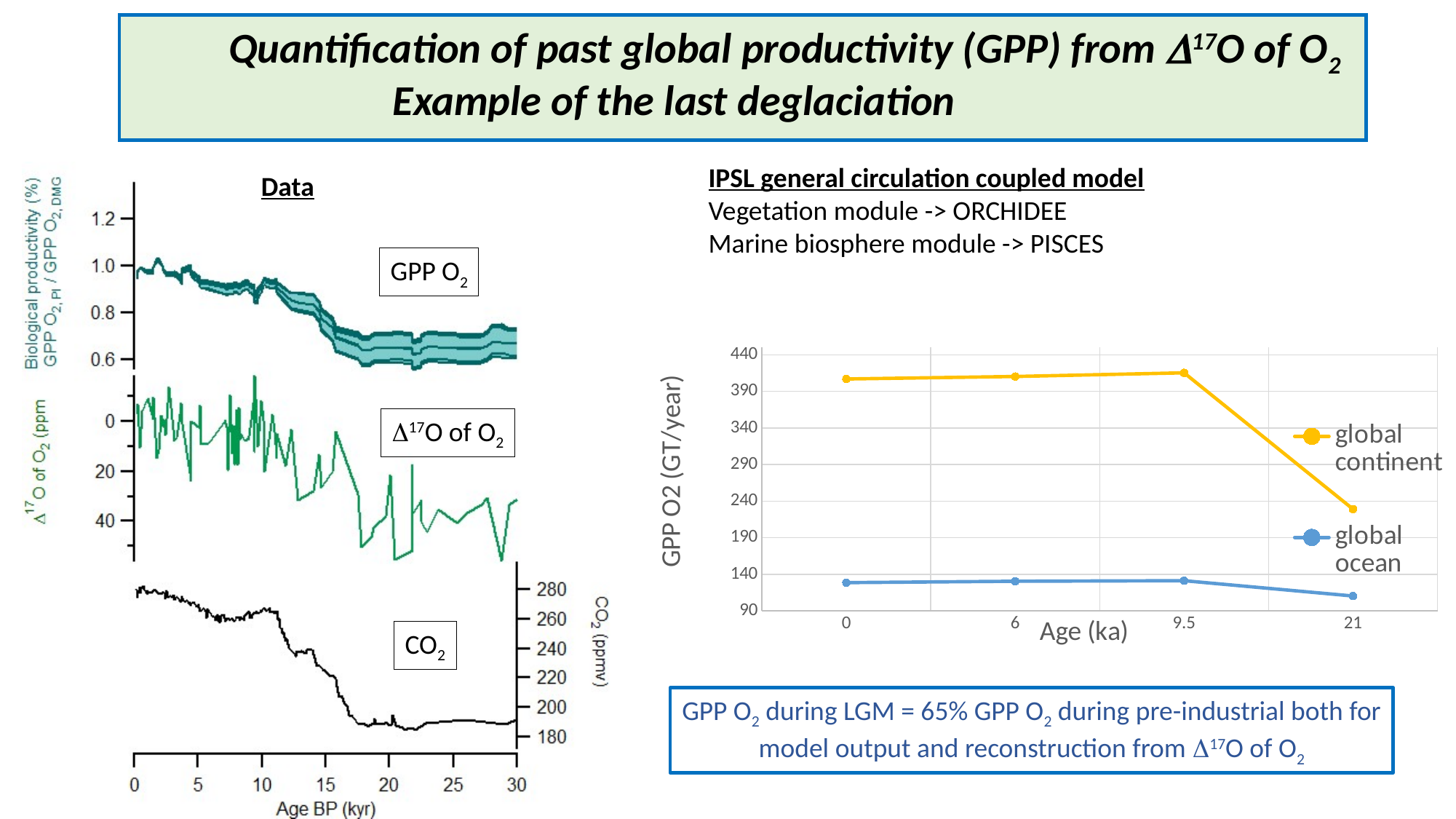
On the right-hand chart of GPP O2 versus Age (ka), what is the label of the y axis? GPP O2 (GT/year) On the left-hand Data panel, does the CO2 curve rise or fall as Age BP increases from 0 to 30 kyr? fall On the right-hand chart of GPP O2 versus Age (ka), is the global ocean value at 21 ka greater or less than 140? less On the right-hand chart of GPP O2 versus Age (ka), how many series does the legend list? 2 On the right-hand chart of GPP O2 versus Age (ka), which series has the higher values throughout? global continent On the right-hand chart of GPP O2 versus Age (ka), how many age points are plotted along the x axis? 4 On the right-hand chart of GPP O2 versus Age (ka), which is larger for global continent: the value at 0 ka or the value at 21 ka? 0 ka On the right-hand chart of GPP O2 versus Age (ka), is the global continent value at 0 ka greater or less than 340? greater On the left-hand Data panel, is the CO2 value at 25 kyr BP greater or less than 220 ppmv? less On the right-hand chart of GPP O2 versus Age (ka), what kind of chart is it? line chart On the right-hand chart of GPP O2 versus Age (ka), does the global continent series rise or fall between 9.5 ka and 21 ka? fall